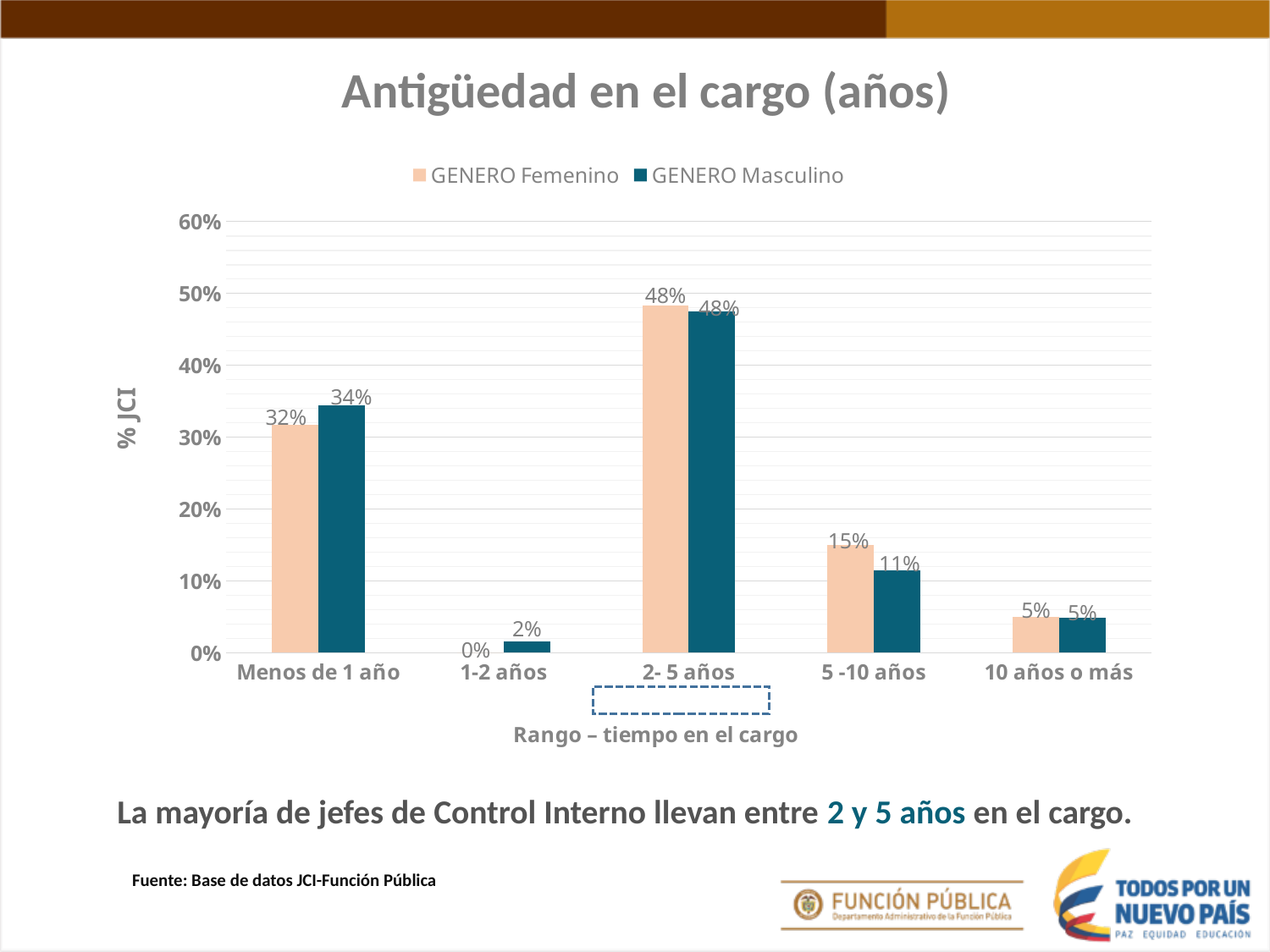
What is the difference between the GENERO Masculino and GENERO Femenino values in the 'Menos de 1 año' category? 2% Which category has the highest value for GENERO Femenino? 2- 5 años What kind of chart is shown on the slide? bar chart Which is larger in the '5 -10 años' category, GENERO Femenino or GENERO Masculino? GENERO Femenino What is the title of the chart? Antigüedad en el cargo (años) Is the value for GENERO Masculino in the '2- 5 años' category greater or less than 40%? greater How many categories are shown on the x axis? 5 Which category has the lowest value for GENERO Femenino? 1-2 años What is the value for GENERO Masculino in the '1-2 años' category? 2% What is the value for GENERO Masculino in the '5 -10 años' category? 11% What is the value for GENERO Femenino in the 'Menos de 1 año' category? 32% How many series does the legend list? 2